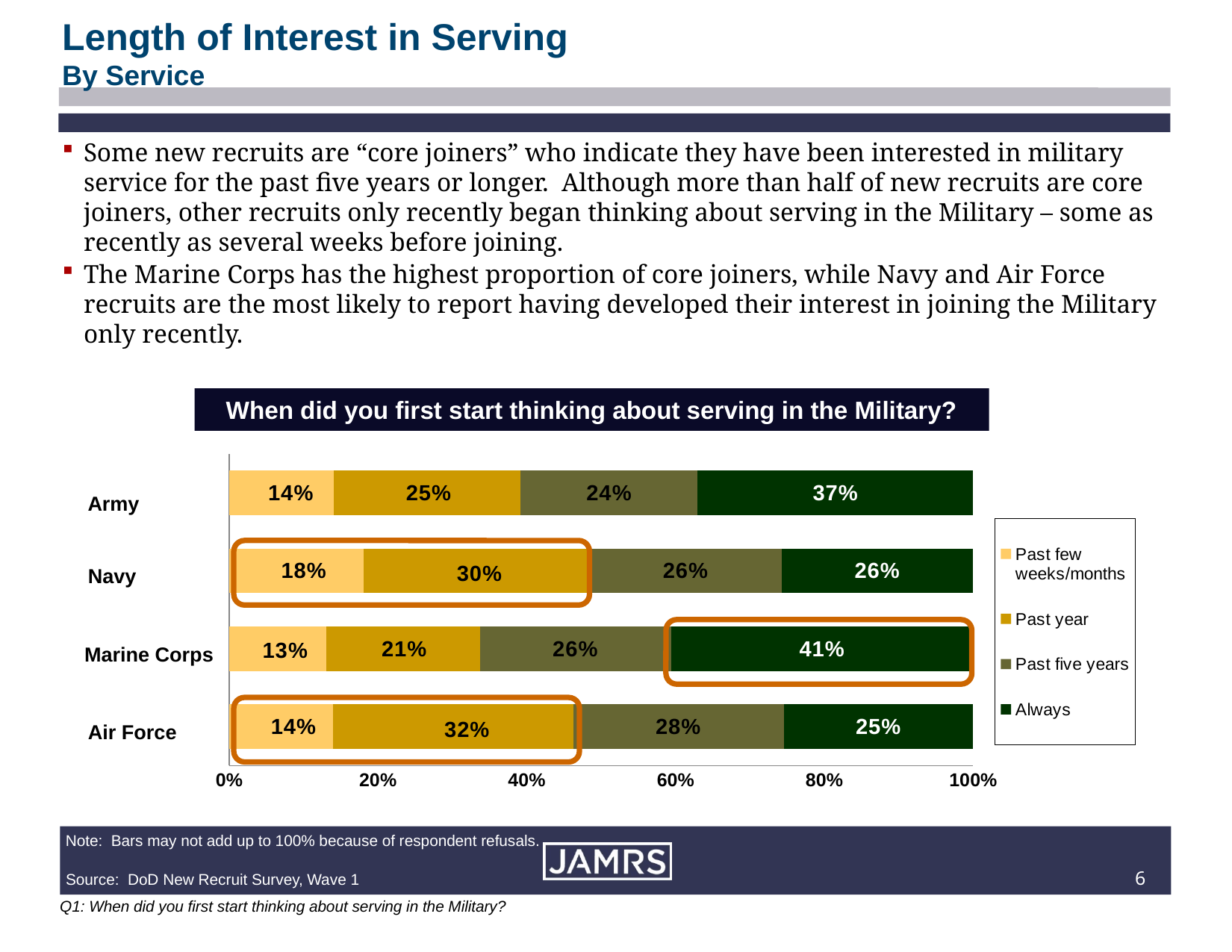
What is the total of the Army bar? 100% Which is larger: the Navy's "Past few weeks/months" value or the Army's "Past few weeks/months" value? Navy Which service has the highest percentage for "Always"? Marine Corps What percentage of Marine Corps recruits answered "Past few weeks/months"? 13% What percentage of Army recruits answered "Always"? 37% How many series does the legend list? 4 What percentage of Air Force recruits answered "Past five years"? 28% What percentage of Navy recruits answered "Past year"? 30% How many services are shown on the chart? 4 Which service has the lowest percentage for "Past year"? Marine Corps What is the difference between the Marine Corps and Air Force percentages for "Always"? 16% What type of chart is shown on the slide? Stacked bar chart